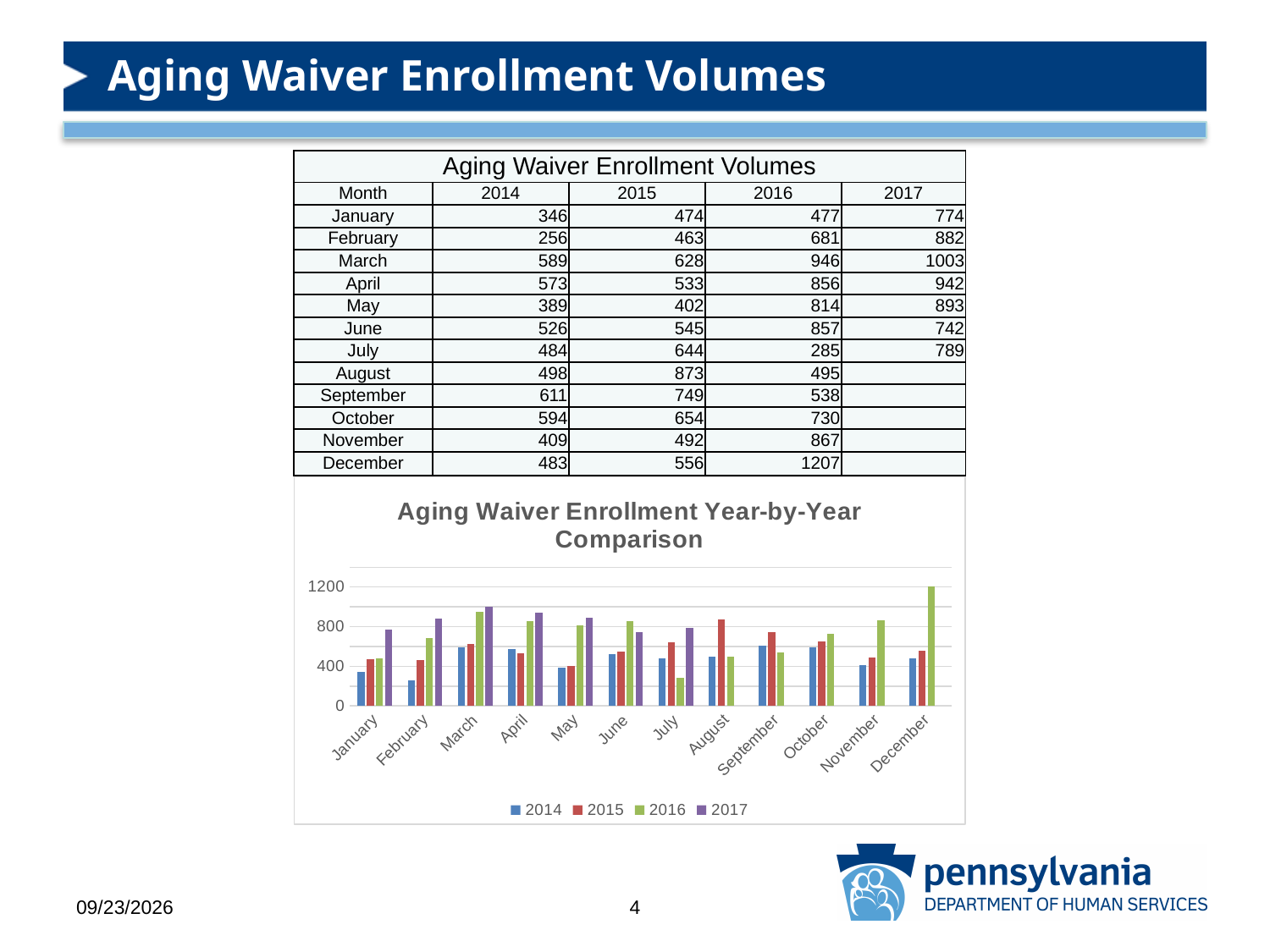
What is the title of the chart? Aging Waiver Enrollment Year-by-Year Comparison Which month has the lowest 2014 enrollment volume? February What is the difference between the 2017 and 2014 enrollment volumes for January? 428 What is the 2017 enrollment volume for March? 1003 How many months have a 2017 bar in the chart? 7 What is the 2016 enrollment volume for December? 1207 How many months are shown along the x axis of the chart? 12 How many series does the legend of the chart list? 4 Which month has the tallest bar in the chart? December For July, which year has the larger enrollment volume, 2015 or 2016? 2015 Is the 2016 value for March greater or less than 800? greater What kind of chart is shown on the slide? bar chart